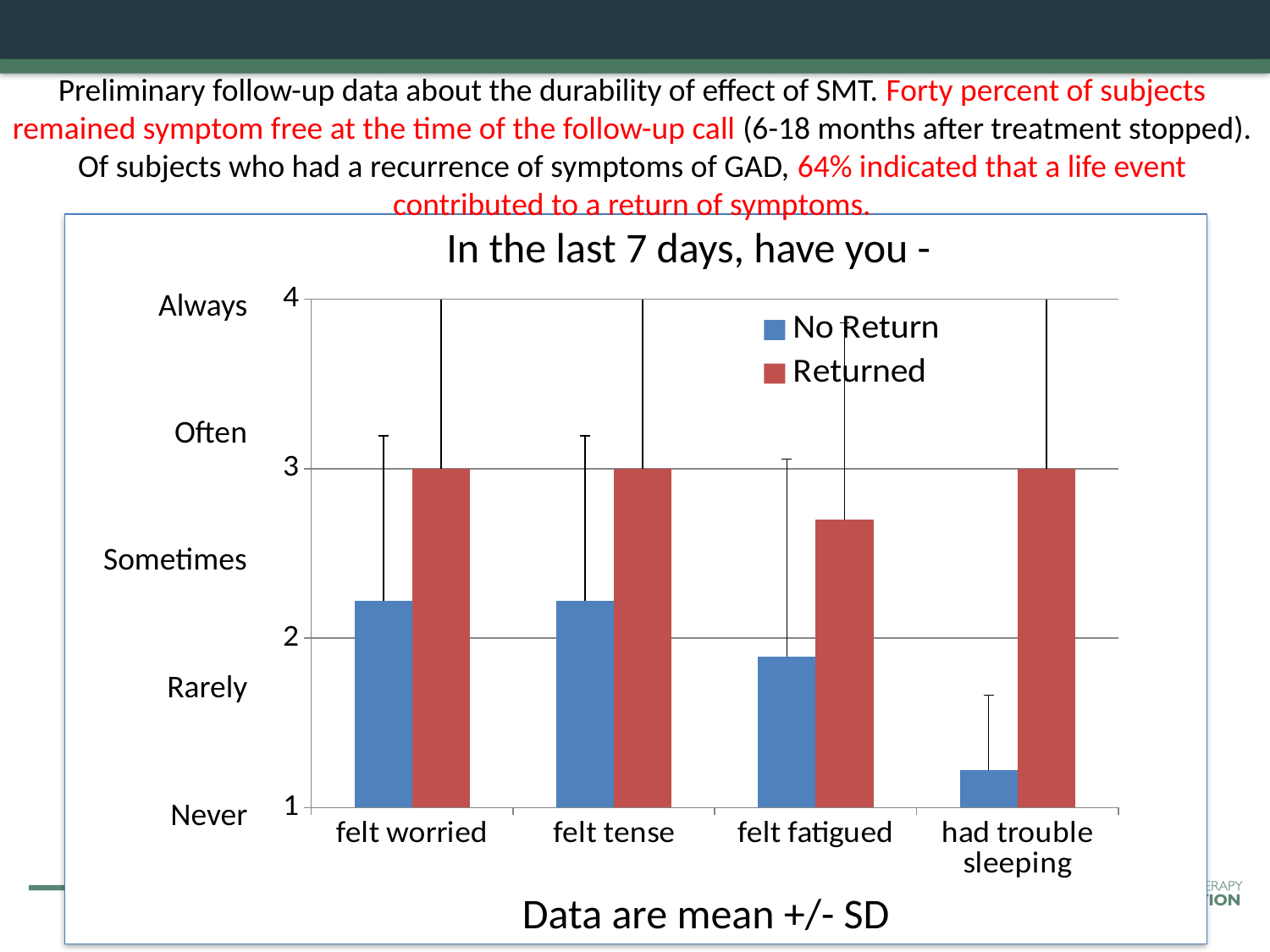
What is the value for the Returned series for 'had trouble sleeping'? 3 Is the No Return value for 'had trouble sleeping' greater or less than 2? less What kind of chart is shown on the slide? bar chart What is the title of the chart? In the last 7 days, have you - What is the value for the Returned series for 'felt worried'? 3 Which category has the lowest value in the Returned series? felt fatigued How many series does the chart legend list? 2 Is the No Return value for 'felt worried' greater or less than 2? greater Which category has the lowest value in the No Return series? had trouble sleeping Is the Returned value for 'felt fatigued' greater or less than 2? greater For 'felt fatigued', which series has the larger value, No Return or Returned? Returned How many categories are shown on the x axis of the chart? 4